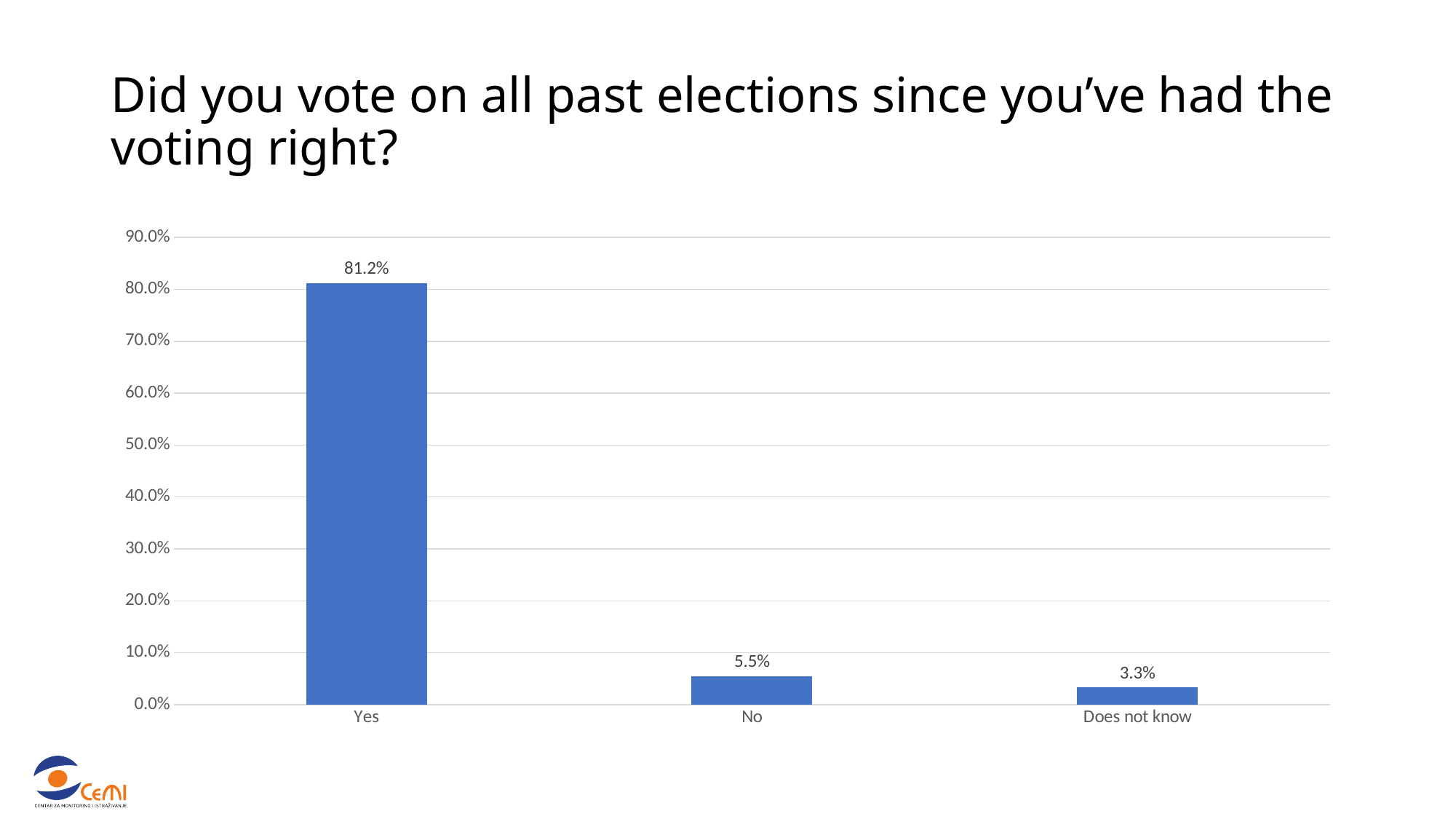
Which category has the lowest value? Does not know What is the value for Yes? 81.2% Which is larger, the value for No or the value for Does not know? No What is the value for No? 5.5% How many categories are shown on the x axis? 3 Which category has the highest value? Yes What is the title of the slide? Did you vote on all past elections since you've had the voting right? What kind of chart is shown on the slide? bar chart What is the difference between the values for No and Does not know? 2.2% What is the value for Does not know? 3.3% What is the difference between the values for Yes and No? 75.7% Is the value for Yes greater or less than 80.0%? greater